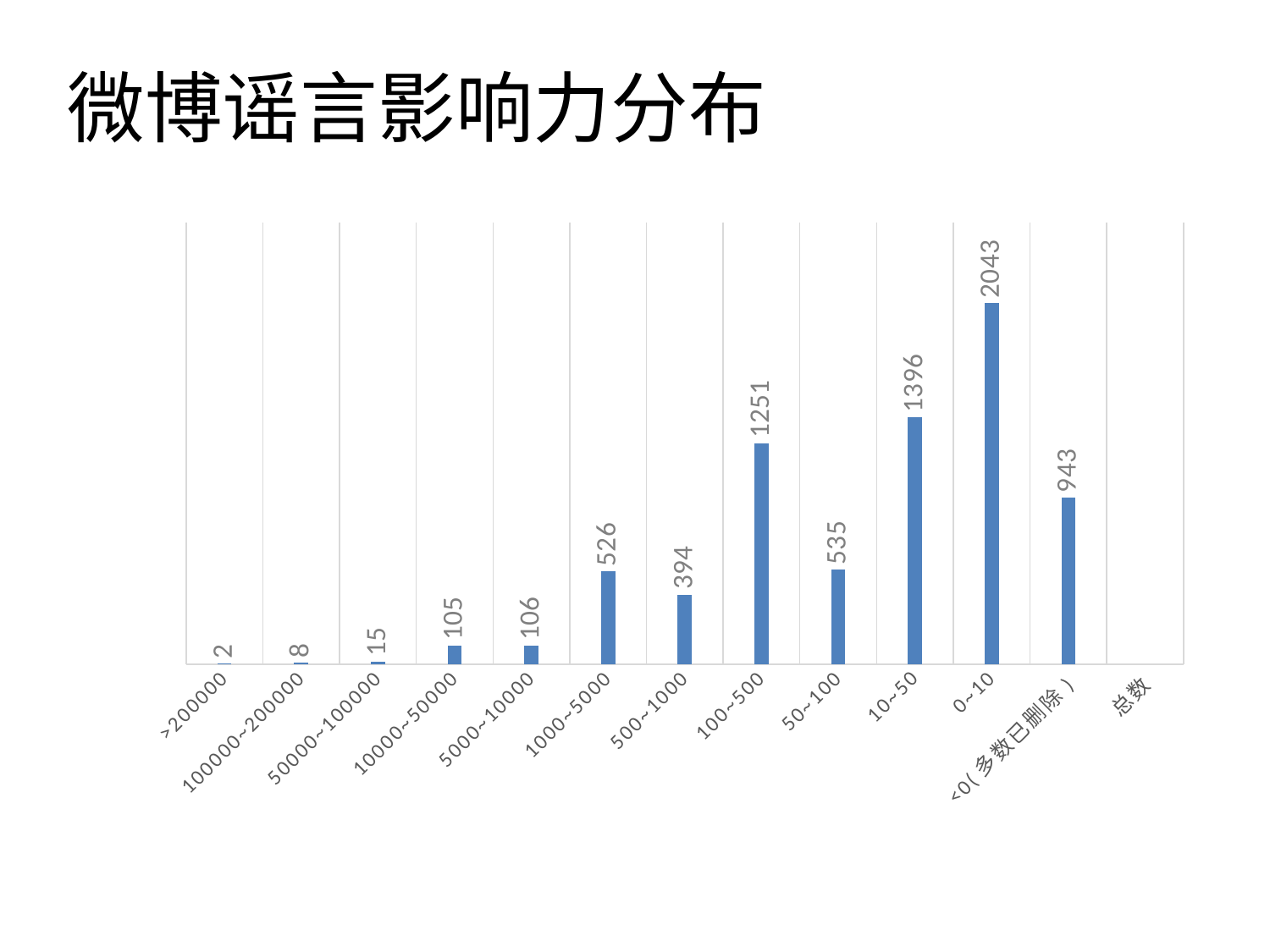
What is the difference between the values for 0~10 and 10~50? 647 What is the value for the 10~50 category? 1396 What is the value for the 50000~100000 category? 15 What is the value for the 0~10 category? 2043 Which is larger, the value for 100~500 or the value for <0(多数已删除)? 100~500 Which is larger, the value for 50~100 or the value for 500~1000? 50~100 Which category has the highest value? 0~10 What kind of chart is shown on the slide? bar chart What is the value for the 100~500 category? 1251 What is the difference between the values for 1000~5000 and 500~1000? 132 What is the title of the slide containing the chart? 微博谣言影响力分布 What is the value for the <0(多数已删除) category? 943